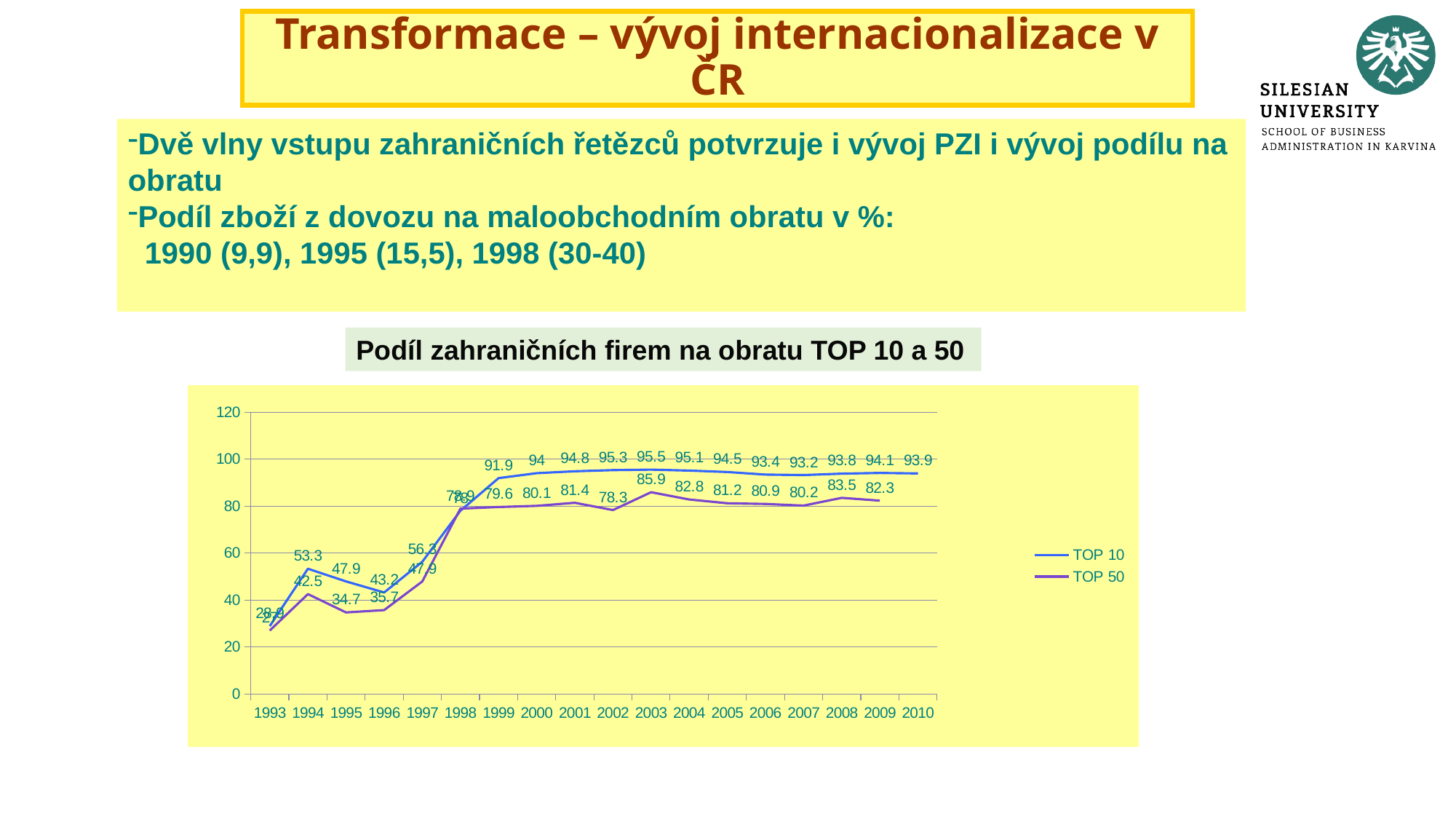
What is the value for TOP 10 in 2003? 95.5 In which year is the TOP 10 series at its lowest value? 1993 How many years are shown on the x axis of the chart? 18 What is the value for TOP 10 in 1994? 53.3 How many series does the chart legend list? 2 What is the difference between TOP 10 and TOP 50 in 2000? 13.9 Which series has the larger value in 1995, TOP 10 or TOP 50? TOP 10 Does the TOP 10 series rise or fall from 1996 to 1999? rise What is the value for TOP 50 in 2009? 82.3 What kind of chart is shown on the slide? line chart In which year does the TOP 10 series reach its highest value? 2003 What is the value for TOP 50 in 2003? 85.9